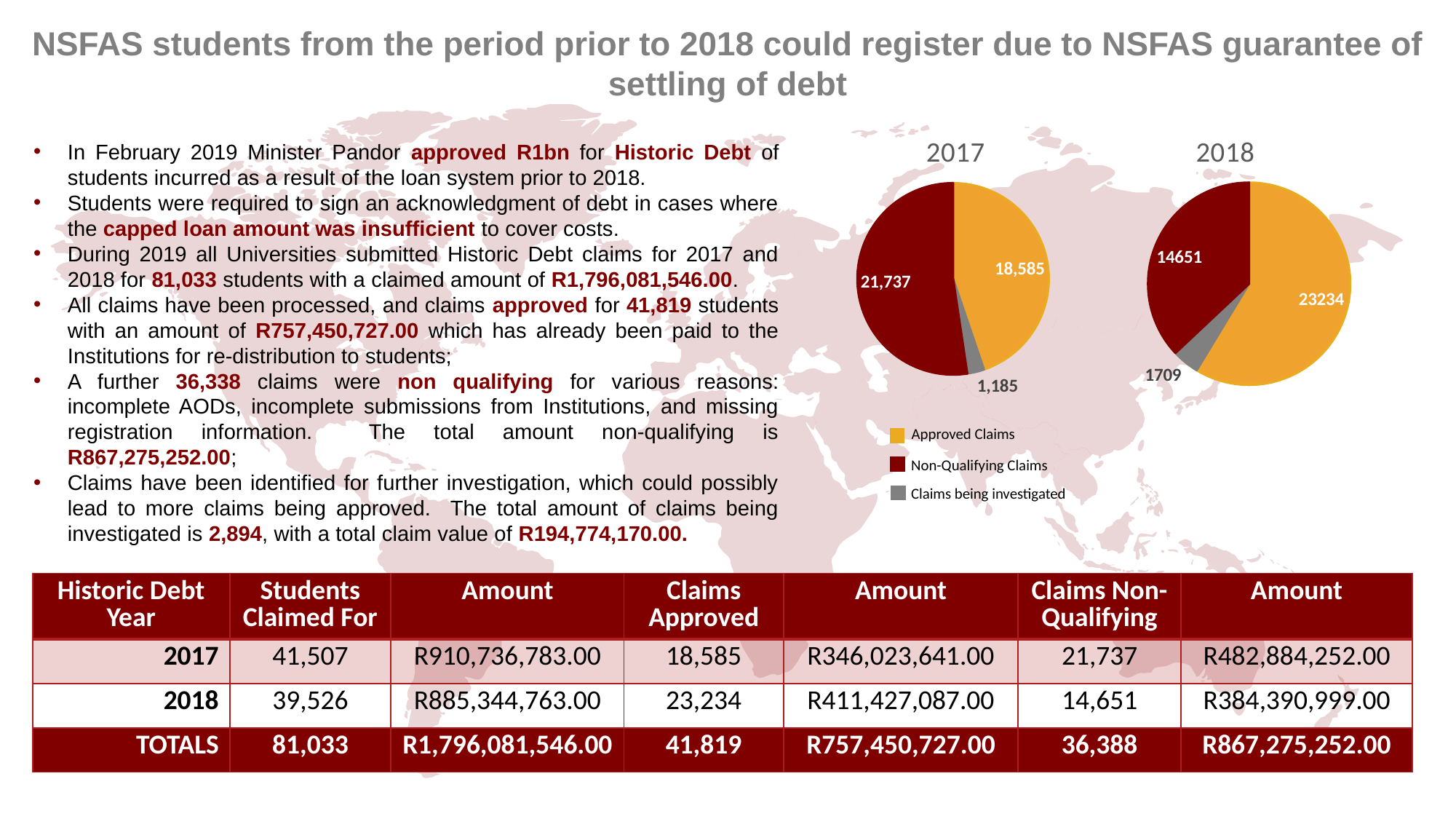
In the 2018 pie chart, what is the value for Claims being investigated? 1709 In the 2018 pie chart, what is the value for Approved Claims? 23234 What kind of charts are shown on the slide for 2017 and 2018? Pie charts In the 2017 pie chart, what is the value for Claims being investigated? 1,185 In the 2017 pie chart, what is the value for Non-Qualifying Claims? 21,737 In the 2018 pie chart, what is the value for Non-Qualifying Claims? 14651 In the 2017 pie chart, what is the value for Approved Claims? 18,585 In the 2017 pie chart, what is the difference between Non-Qualifying Claims and Approved Claims? 3,152 In the 2017 pie chart, which category has the largest slice? Non-Qualifying Claims How many entries does the legend for the pie charts list? 3 In the 2018 pie chart, which category has the smallest slice? Claims being investigated In the 2018 pie chart, which is larger: Approved Claims or Non-Qualifying Claims? Approved Claims